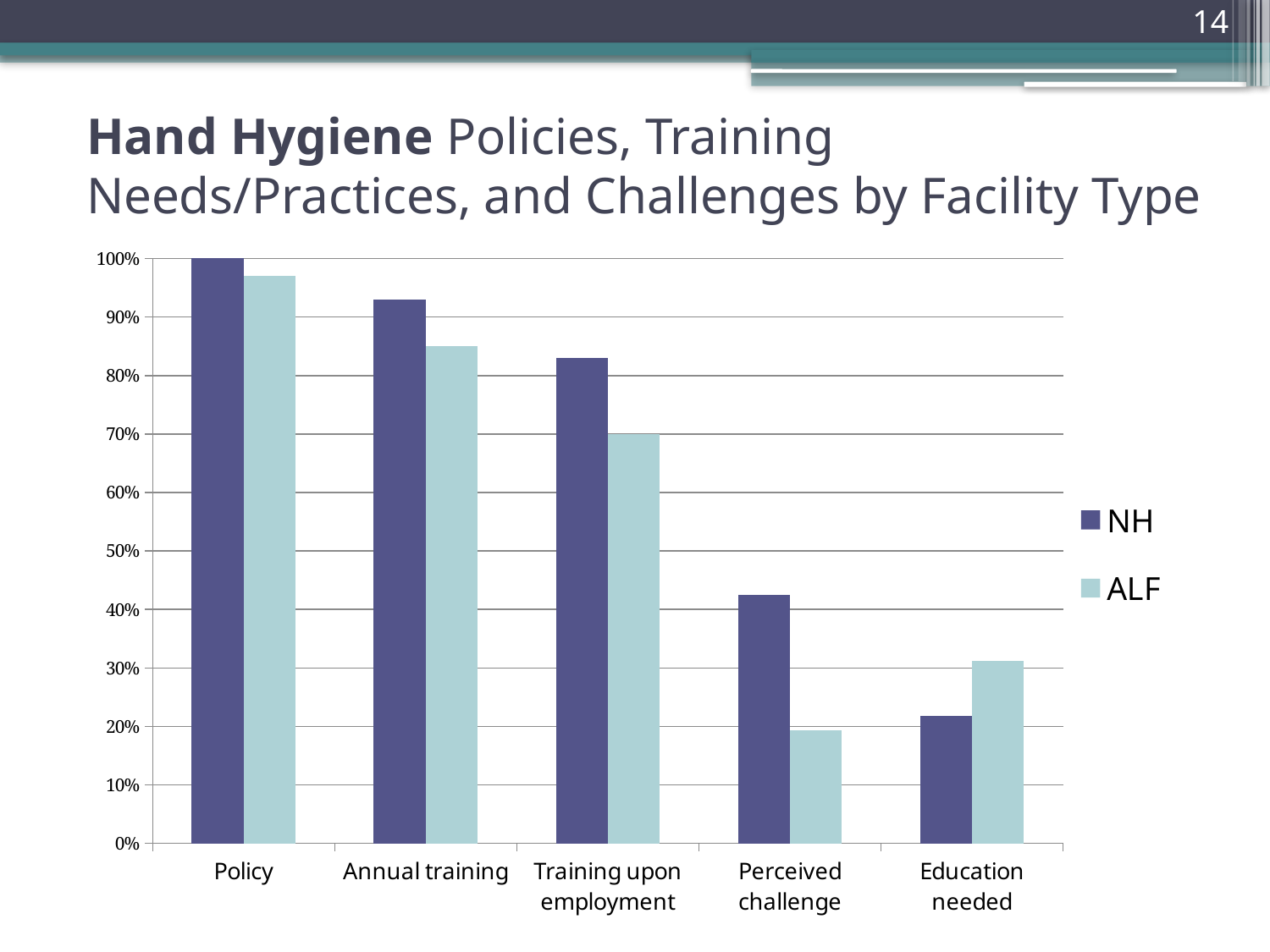
For Education needed, which is larger, the NH value or the ALF value? ALF What is the NH value for Policy? 100% Is the NH value for Perceived challenge greater or less than 40%? greater What type of chart is shown on the slide? bar chart Which category has the lowest NH value? Education needed Which category has the lowest ALF value? Perceived challenge Which category has the highest NH value? Policy Is the ALF value for Annual training greater or less than 90%? less Do the NH values rise or fall moving from Policy to Education needed along the x axis? fall How many categories are shown on the x axis? 5 How many series does the legend list? 2